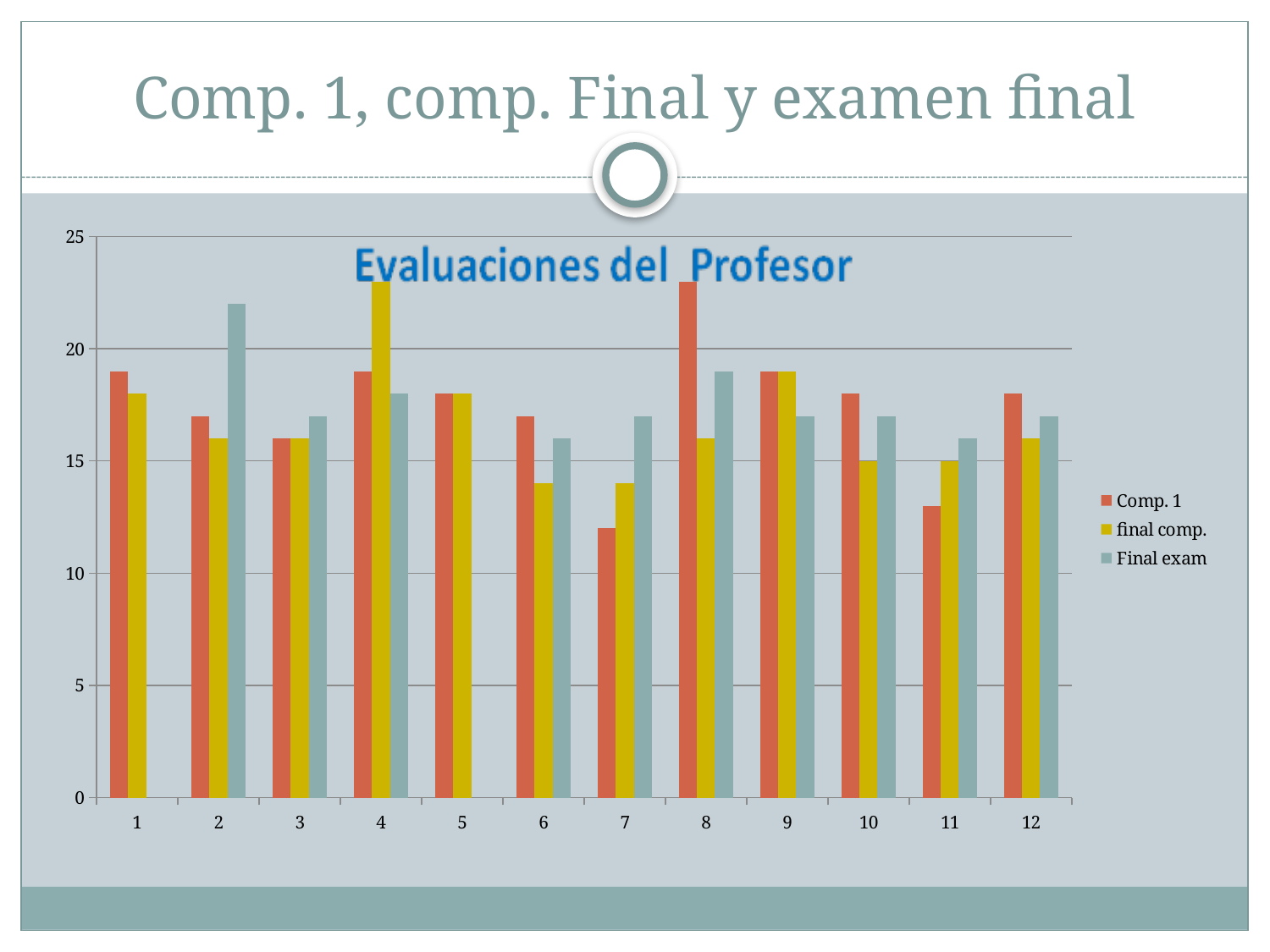
What are the three series named in the chart's legend? Comp. 1, final comp., Final exam Is the Comp. 1 value for category 7 greater or less than 15? less How many series does the chart's legend list? 3 What is the title printed inside the chart area? Evaluaciones del Profesor For category 2, which is larger: the Comp. 1 value or the Final exam value? Final exam For which category is the final comp. value the highest? 4 For which category is the Comp. 1 value the highest? 8 For which category is the Comp. 1 value the lowest? 7 Is the Comp. 1 value for category 8 greater or less than 20? greater What kind of chart is shown on the slide? bar chart For which category is the Final exam value the highest? 2 How many categories are shown along the x axis of the chart? 12